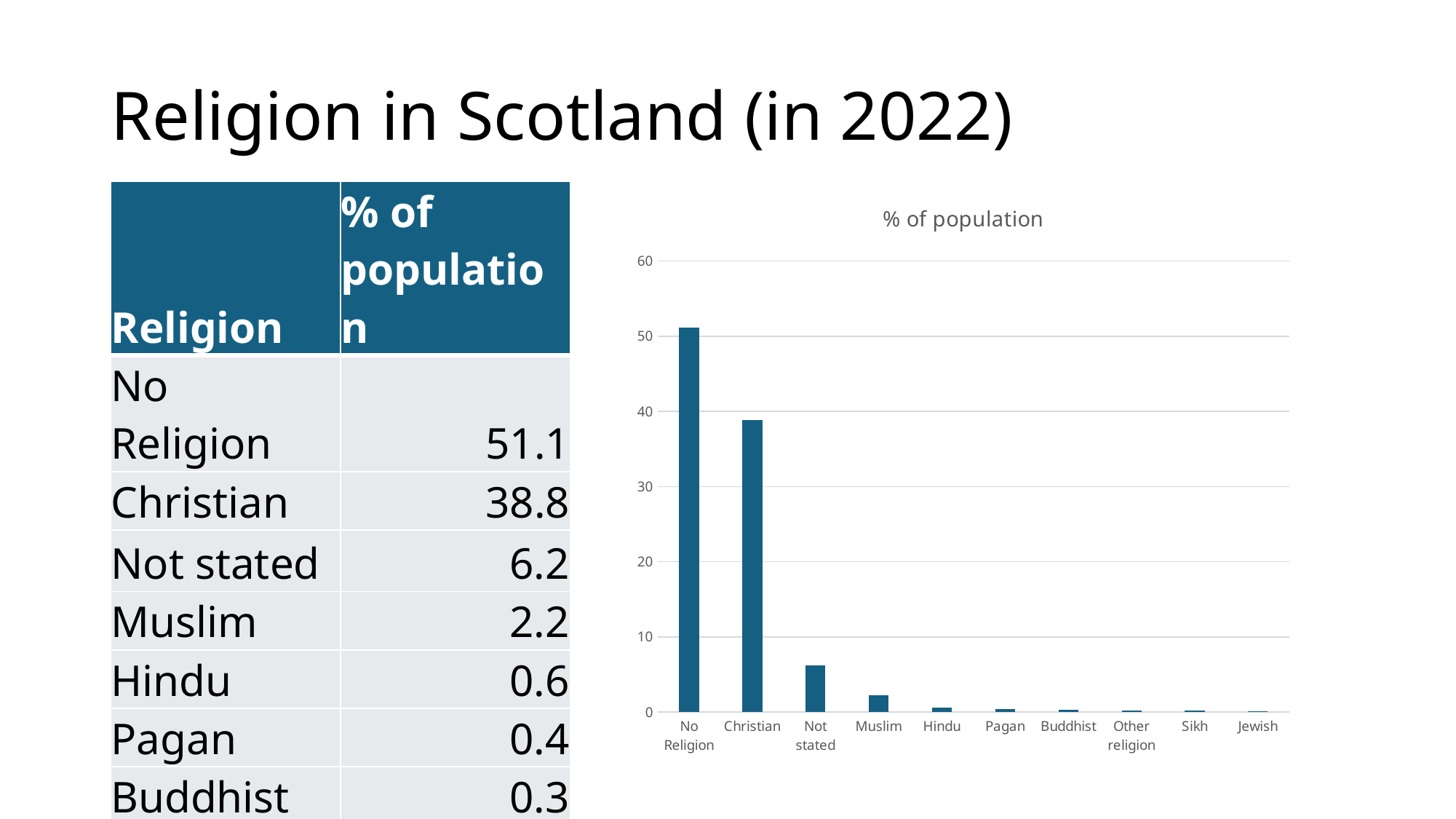
Which category has the highest bar in the chart? No Religion Is the value for Christian greater or less than 40? less Is the value for No Religion greater or less than 50? greater What is the difference in % of population between No Religion and Christian? 12.3 Which is larger, the value for Not stated or the value for Muslim? Not stated What is the title of the chart? % of population How many religion categories are plotted on the chart's x axis? 10 What is the % of population for Christian? 38.8 What is the % of population for Not stated? 6.2 What is the % of population for No Religion? 51.1 What kind of chart is shown on the slide? bar chart What is the % of population for Muslim? 2.2